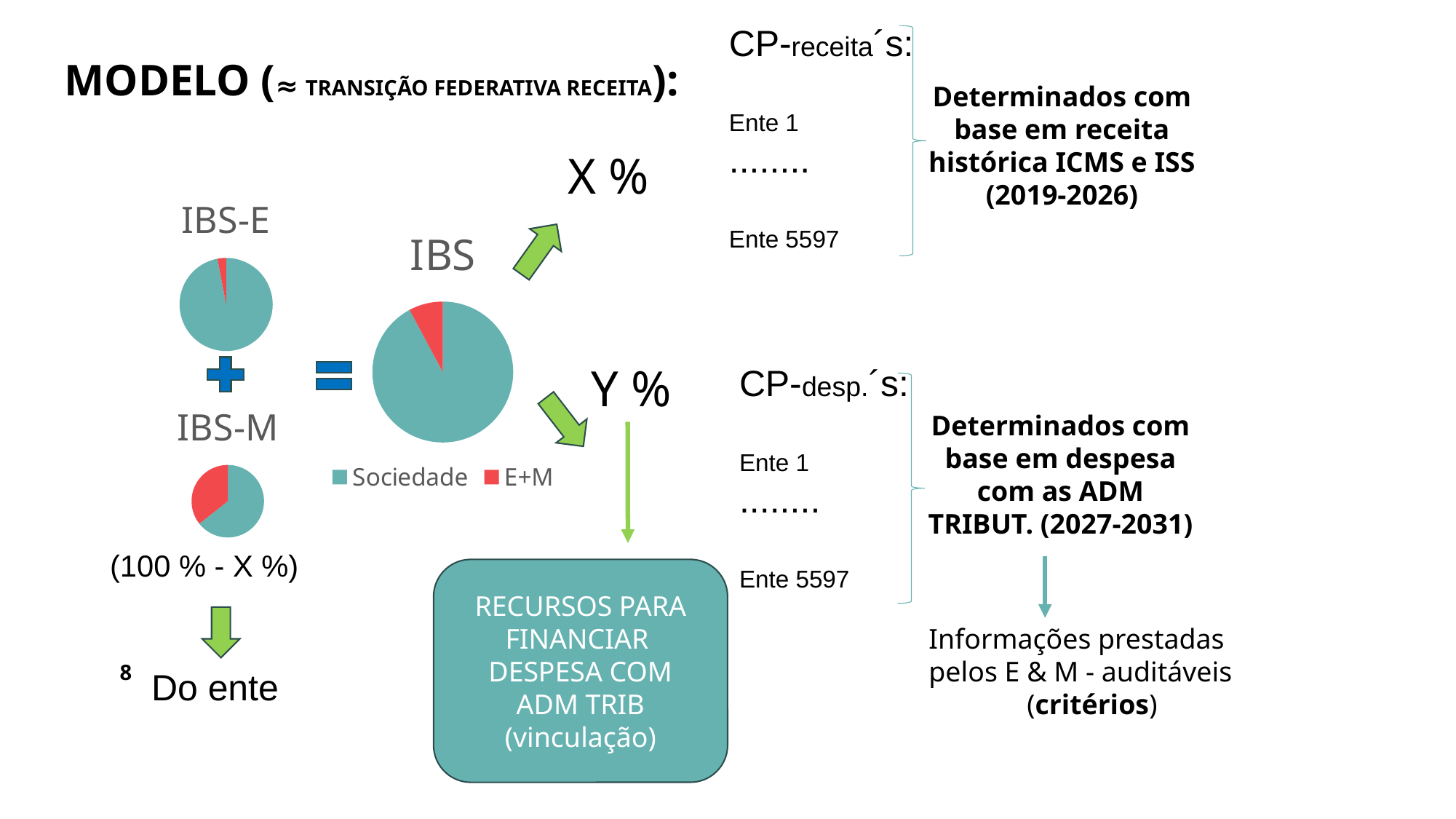
In the IBS chart, which slice is larger, Sociedade or E+M? Sociedade Which of the three pie charts has the largest E+M slice? IBS-M What kind of chart is the chart titled IBS-M? pie chart What kind of chart is the chart titled IBS-E? pie chart How many entries does the legend below the IBS chart list? 2 What kind of chart is the chart titled IBS? pie chart In the IBS-E chart, which slice is larger, Sociedade or E+M? Sociedade What colour represents E+M in the legend below the IBS chart? red What are the two legend entries shown below the IBS chart? Sociedade and E+M How many slices does the IBS pie chart have? 2 Which of the three pie charts has the smallest E+M slice? IBS-E In the IBS-M chart, which slice is larger, Sociedade or E+M? Sociedade